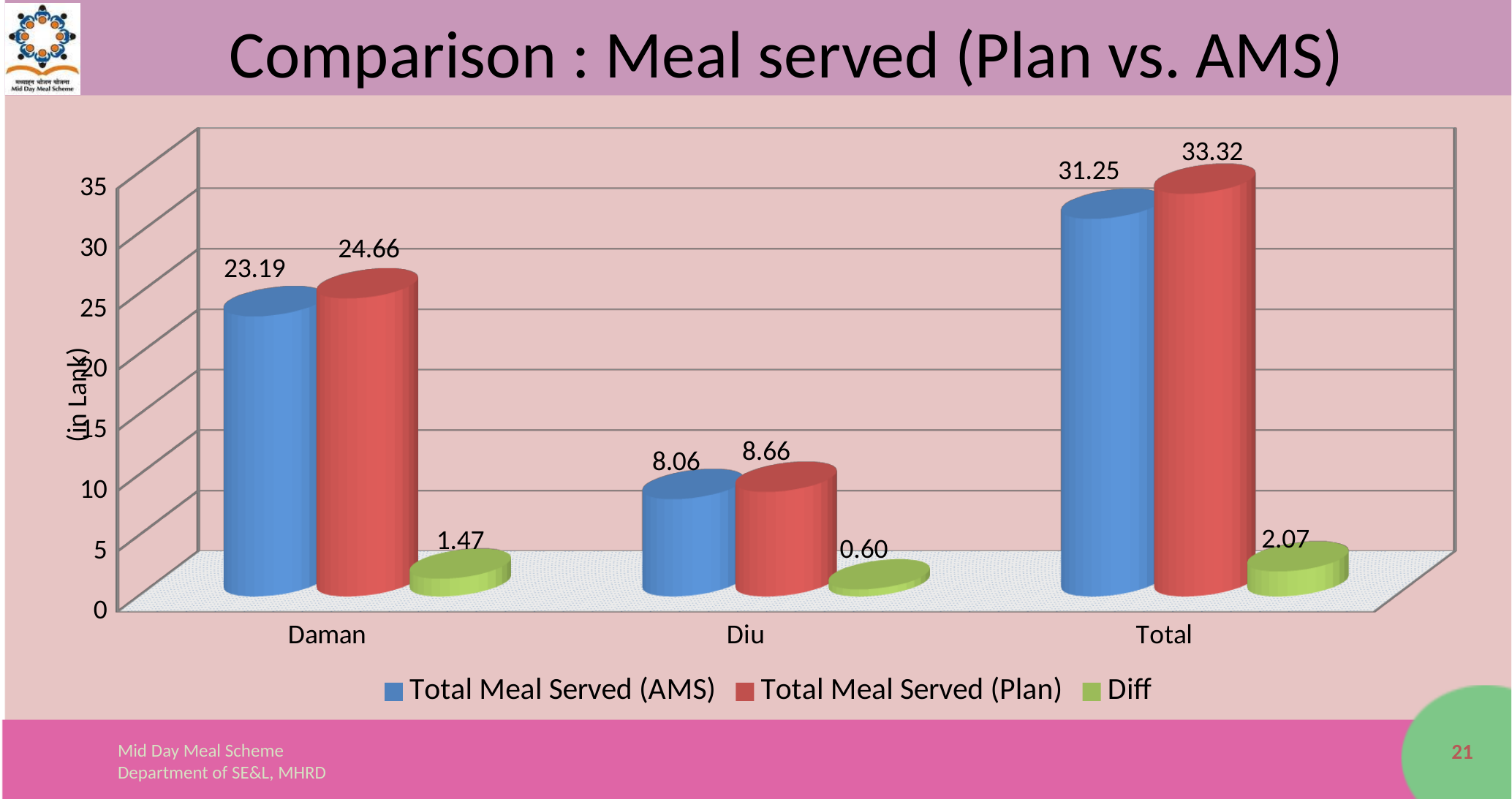
What is the difference between the Plan and AMS values for Daman? 1.47 How many series does the legend list? 3 What is the Total Meal Served (AMS) value for Daman? 23.19 Which category has the highest Diff value? Total What is the Total Meal Served (Plan) value for Total? 33.32 What is the title of the chart? Comparison : Meal served (Plan vs. AMS) How many categories are shown on the x axis? 3 What is the Total Meal Served (Plan) value for Diu? 8.66 What kind of chart is shown on the slide? Bar chart What is the Diff value for Total? 2.07 Which category has the lowest Total Meal Served (AMS) value? Diu Which is larger for Diu: Total Meal Served (AMS) or Total Meal Served (Plan)? Total Meal Served (Plan)